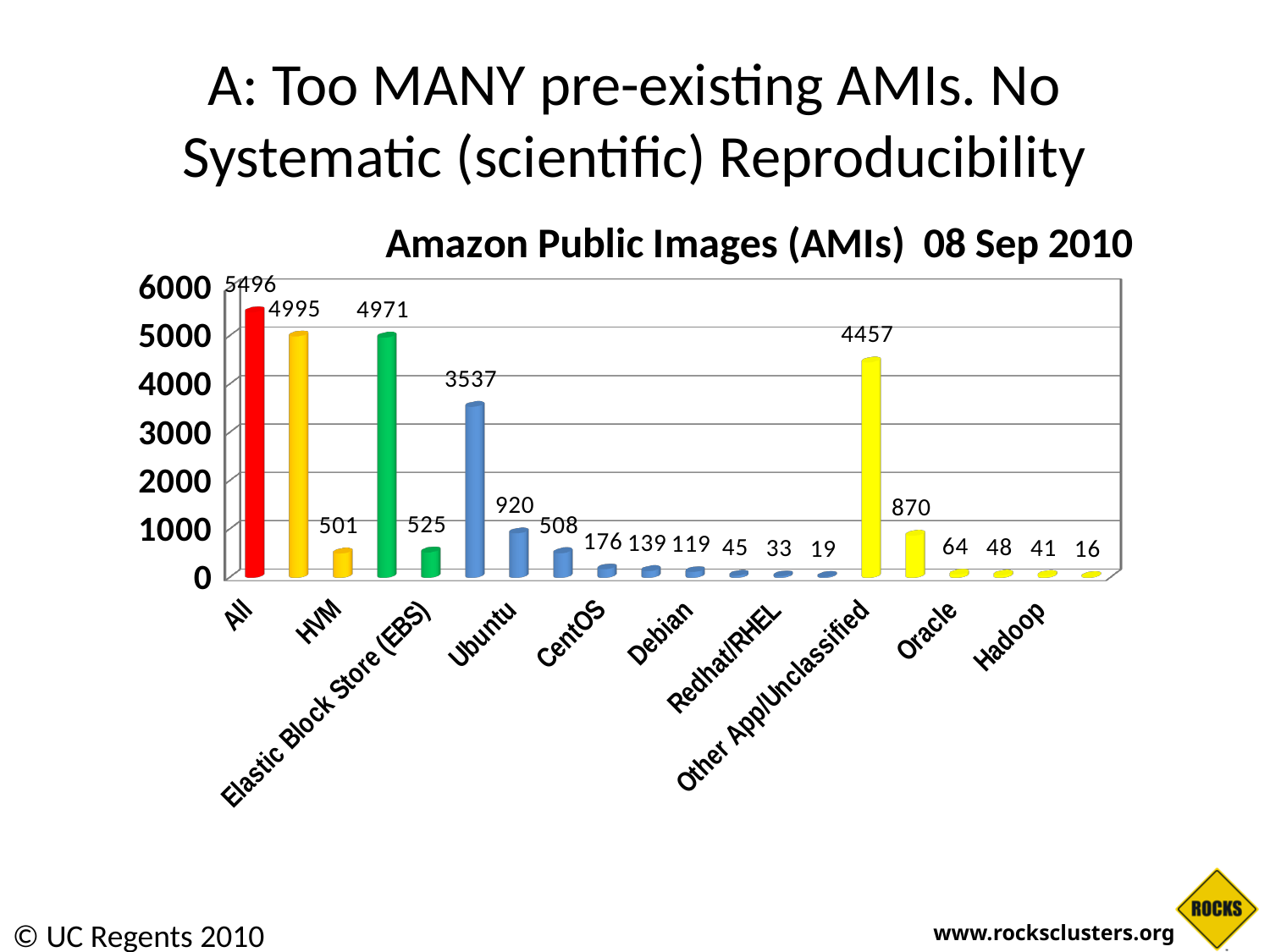
What is the difference between the 'All' value and the 'Other App/Unclassified' value? 1039 Is the value for 'All' greater or less than 5000? greater What is the value for the 'All' category? 5496 How many bars are plotted on the chart? 20 What is the title of the chart? Amazon Public Images (AMIs) 08 Sep 2010 What is the smallest value labelled on the chart? 16 What is the value for 'Other App/Unclassified'? 4457 What colour is the bar for the 'All' category? red What kind of chart is shown on the slide? bar chart Which category has the highest value? All Which is larger, the value for 'Ubuntu' or the value for 'HVM'? Ubuntu What is the value for 'Ubuntu'? 920